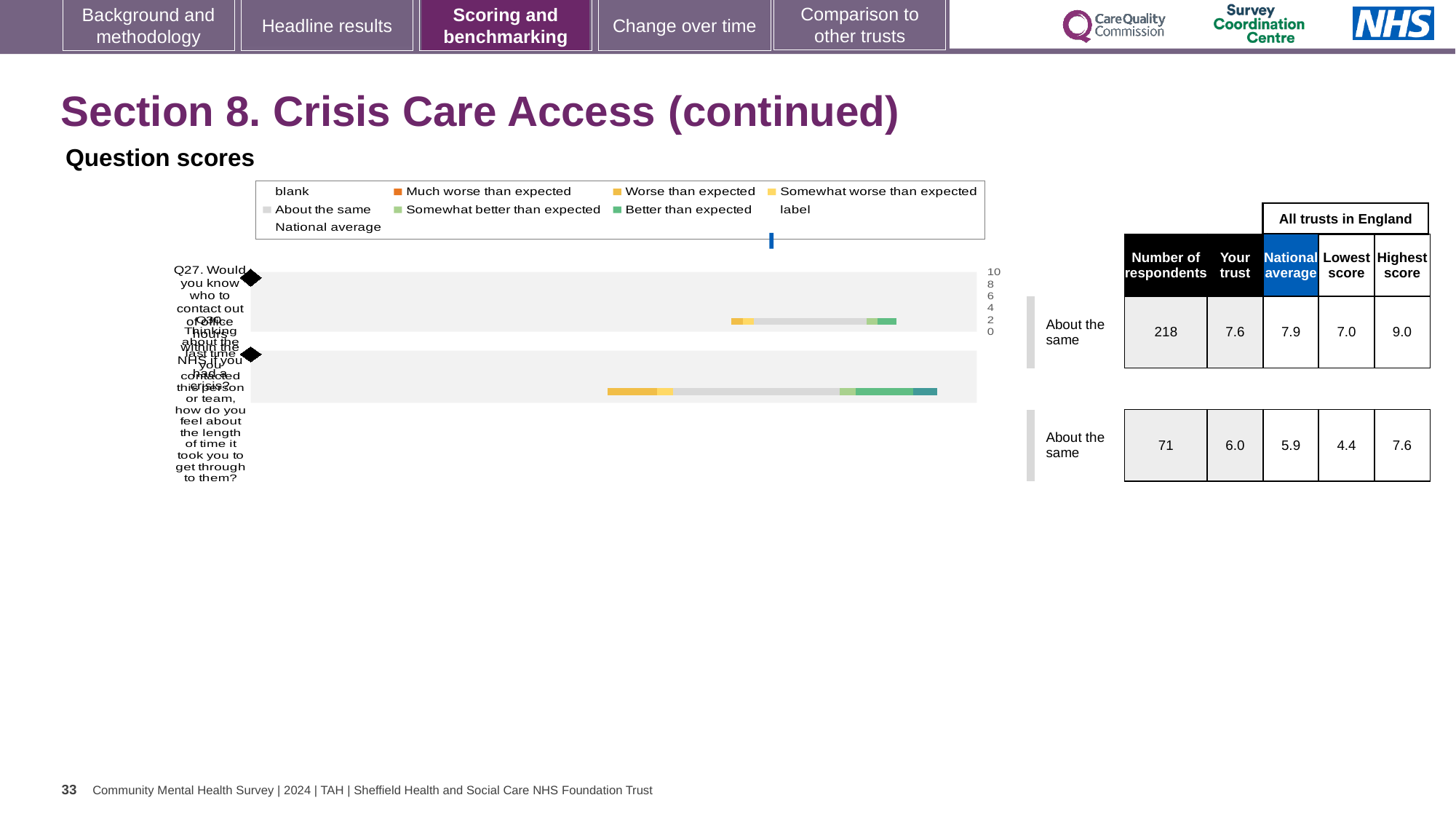
What kind of chart is used to show the question scores on this slide? Bar chart What is the highest score among all trusts in England for Q30? 7.6 What is the difference between the highest and lowest scores for Q30 across all trusts in England? 3.2 For Q30, which is larger: the 'Your trust' score or the national average? Your trust Which question has the higher 'Your trust' score, Q27 or Q30? Q27 What is the 'Your trust' score for Q27? 7.6 What is the difference between the highest and lowest scores for Q27 across all trusts in England? 2.0 What is the national average score for Q27? 7.9 For Q27, which is larger: the 'Your trust' score or the national average? National average How many respondents answered Q27? 218 How many questions are plotted in the question scores chart? 2 How many respondents answered Q30? 71